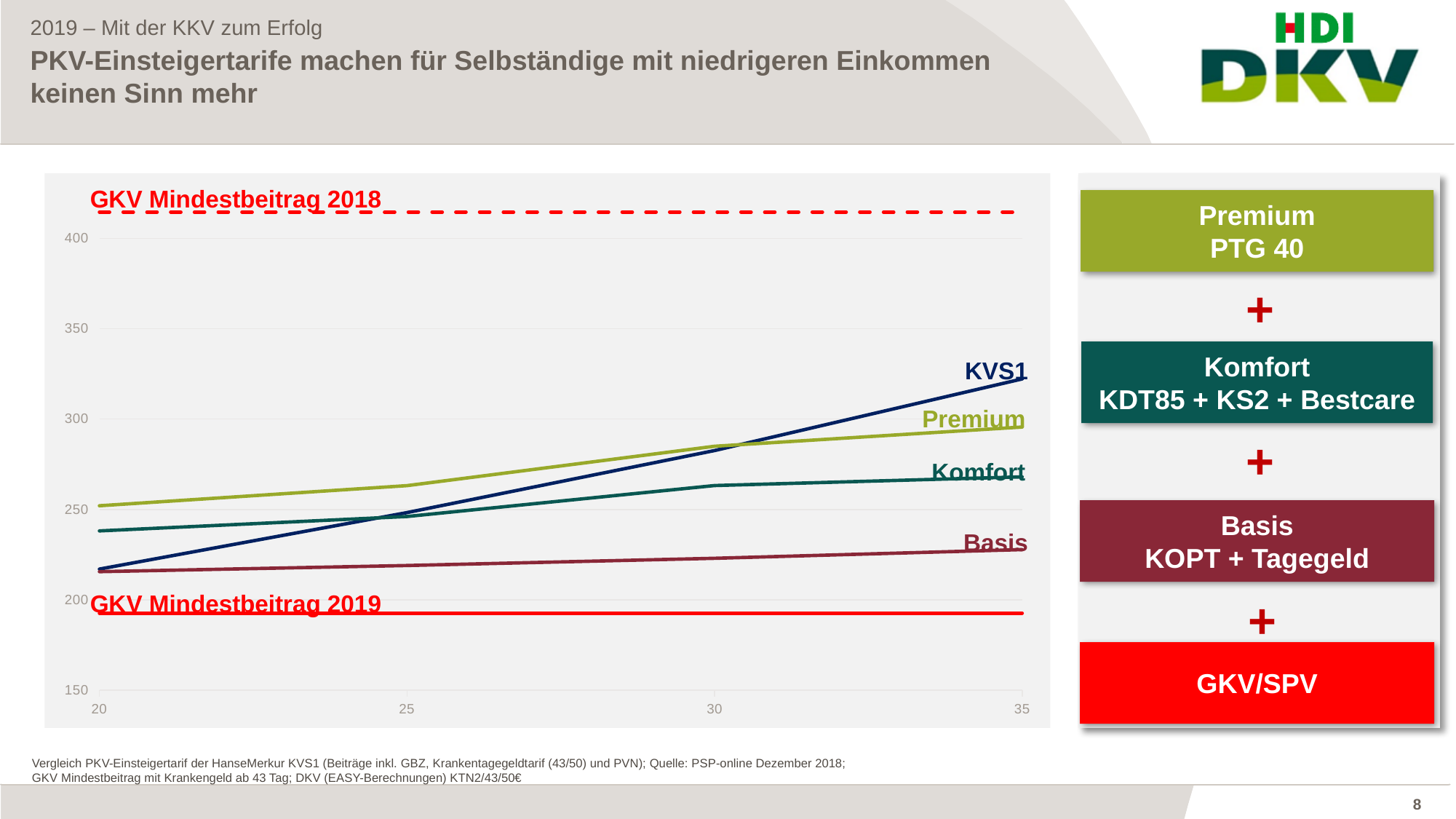
What kind of chart is shown on the slide? line chart Is the value of Basis at x = 35 greater or less than 250? less How many tick labels are shown on the x axis? 4 Is the GKV Mindestbeitrag 2019 line above or below 200? below Does the KVS1 line rise or fall from x = 20 to x = 35? rise At x = 35, which is larger: KVS1 or Komfort? KVS1 Is the value of KVS1 at x = 35 greater or less than 300? greater Which reference line is drawn as a dashed line? GKV Mindestbeitrag 2018